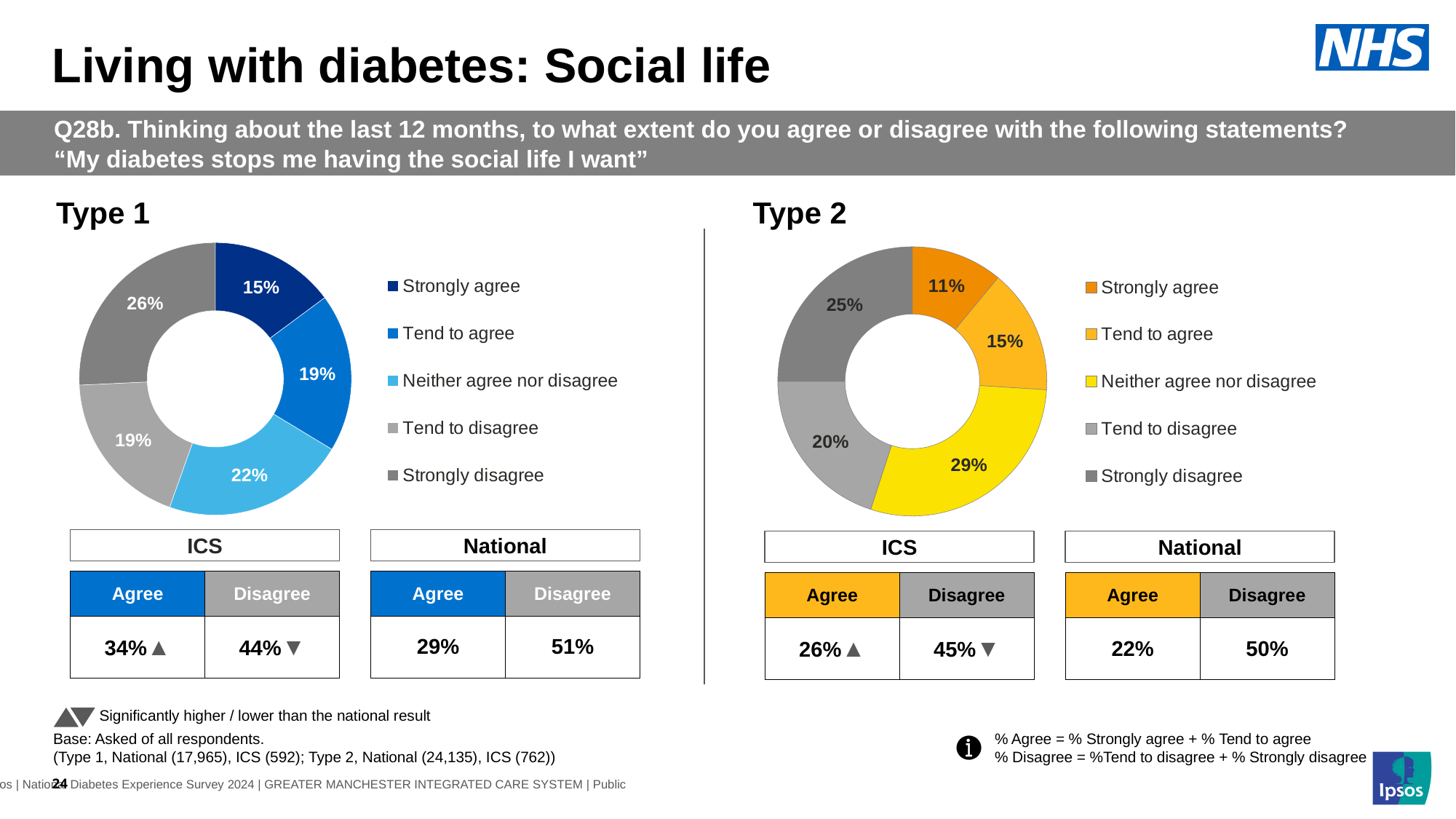
In the Type 2 chart, what is the difference in percentage points between 'Neither agree nor disagree' and 'Strongly agree'? 18 percentage points In the Type 2 chart, what percentage of respondents said 'Tend to agree'? 15% What kind of chart is used for the Type 2 results? Doughnut (pie) chart In the Type 2 chart, what percentage of respondents said 'Tend to disagree'? 20% In the Type 2 chart, which is larger: 'Strongly disagree' or 'Tend to disagree'? Strongly disagree In the Type 1 chart, what is the difference in percentage points between 'Strongly disagree' and 'Neither agree nor disagree'? 4 percentage points In the Type 1 chart, which response category has the largest share? Strongly disagree In the Type 1 chart, what percentage of respondents said 'Strongly agree'? 15% How many response categories are shown in the Type 1 chart? 5 In the Type 2 chart, which response category has the largest share? Neither agree nor disagree In the Type 1 chart, what percentage of respondents said 'Neither agree nor disagree'? 22% In the Type 2 chart, which response category has the smallest share? Strongly agree